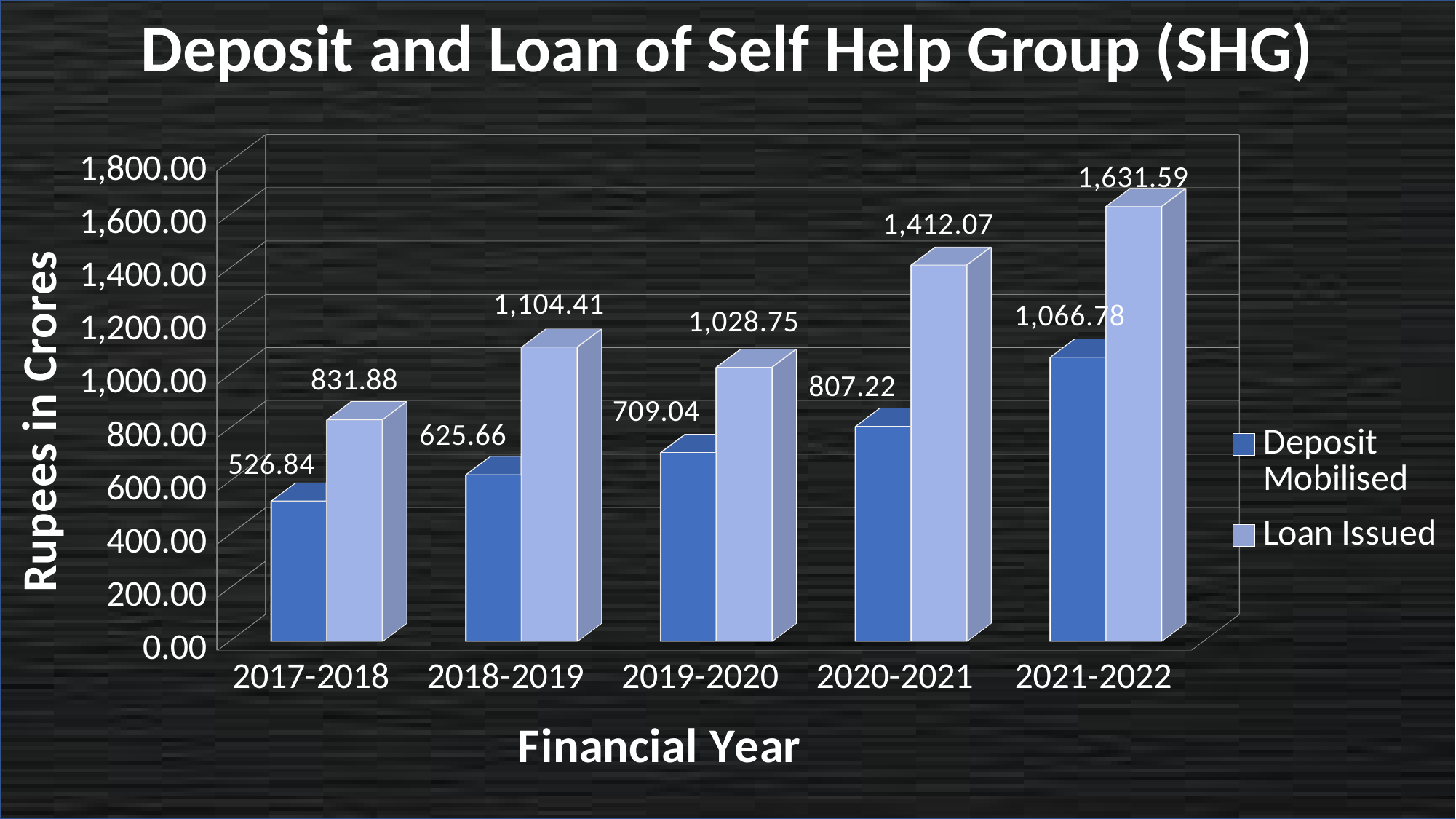
Which was larger in 2019-2020, Deposit Mobilised or Loan Issued? Loan Issued What is the difference between Loan Issued and Deposit Mobilised in 2021-2022? 564.81 What kind of chart is shown on the slide? Bar chart What is the title of the chart? Deposit and Loan of Self Help Group (SHG) In which financial year was the Deposit Mobilised lowest? 2017-2018 How many financial years are shown on the x axis? 5 In which financial year was the Loan Issued highest? 2021-2022 What was the Deposit Mobilised in 2017-2018? 526.84 How many series does the legend list? 2 Does the Loan Issued rise or fall from 2017-2018 to 2021-2022? Rise What was the Deposit Mobilised in 2021-2022? 1,066.78 What was the Loan Issued in 2020-2021? 1,412.07